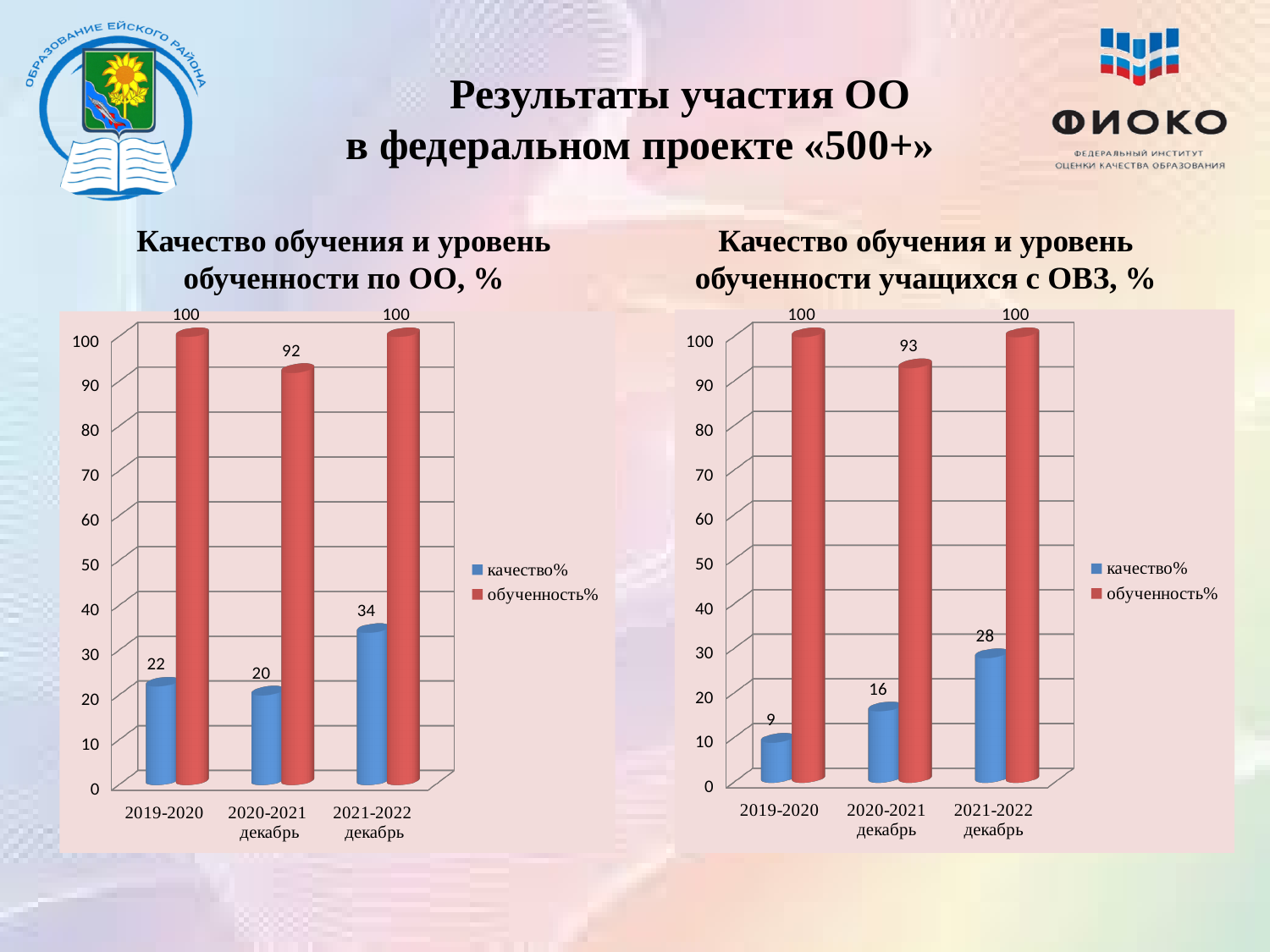
In the right chart (Качество обучения и уровень обученности учащихся с ОВЗ, %), what is the value of обученность% for 2020-2021 декабрь? 93 In the left chart (Качество обучения и уровень обученности по ОО, %), what is the value of качество% for 2021-2022 декабрь? 34 How many periods are shown on the x axis of the right chart (Качество обучения и уровень обученности учащихся с ОВЗ, %)? 3 In the left chart (Качество обучения и уровень обученности по ОО, %), what is the value of обученность% for 2020-2021 декабрь? 92 In the right chart (Качество обучения и уровень обученности учащихся с ОВЗ, %), which period has the highest качество% value? 2021-2022 декабрь In the left chart (Качество обучения и уровень обученности по ОО, %), which period has the lowest качество% value? 2020-2021 декабрь In the left chart (Качество обучения и уровень обученности по ОО, %), what is the difference between обученность% and качество% for 2021-2022 декабрь? 66 What kind of chart is the right chart (Качество обучения и уровень обученности учащихся с ОВЗ, %)? Bar chart How many series does the legend of the left chart (Качество обучения и уровень обученности по ОО, %) list? 2 In the right chart (Качество обучения и уровень обученности учащихся с ОВЗ, %), what is the value of качество% for 2019-2020? 9 In the right chart (Качество обучения и уровень обученности учащихся с ОВЗ, %), what is the difference between качество% for 2021-2022 декабрь and 2019-2020? 19 Which is larger: качество% for 2019-2020 in the left chart or качество% for 2019-2020 in the right chart? Left chart (22)